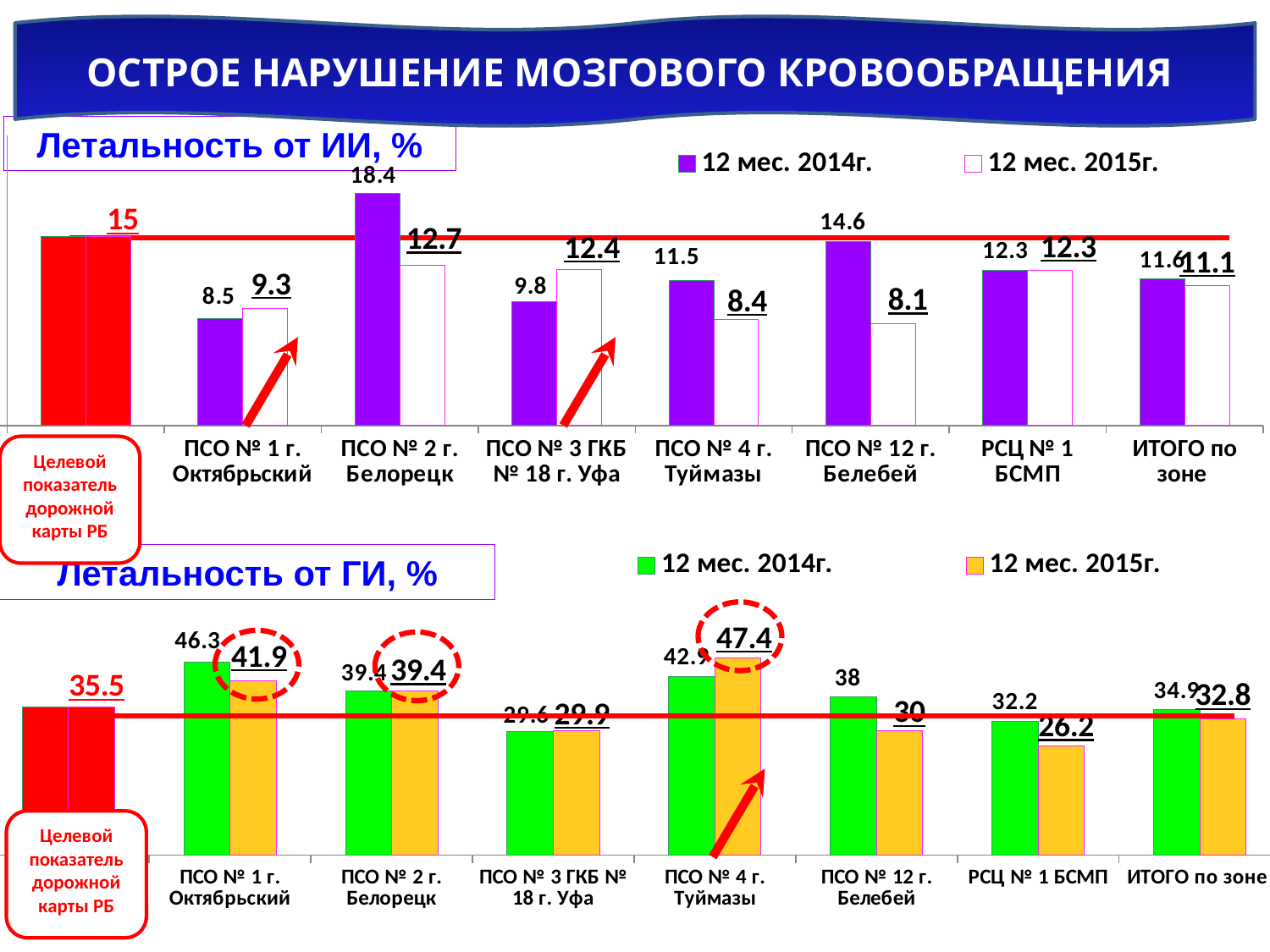
In the chart 'Летальность от ИИ, %', which category has the lowest value for 12 мес. 2015г.? ПСО № 12 г. Белебей In the chart 'Летальность от ИИ, %', which category has the highest value for 12 мес. 2014г.? ПСО № 2 г. Белорецк In the chart 'Летальность от ГИ, %', which category has the highest value for 12 мес. 2015г.? ПСО № 4 г. Туймазы In the chart 'Летальность от ИИ, %', what is the value for ПСО № 12 г. Белебей in 12 мес. 2015г.? 8.1 In the chart 'Летальность от ИИ, %', what is the target value (Целевой показатель) shown by the red bar? 15 In the chart 'Летальность от ГИ, %', what is the value for ИТОГО по зоне in 12 мес. 2014г.? 34.9 In the chart 'Летальность от ИИ, %', what is the value for ПСО № 2 г. Белорецк in 12 мес. 2014г.? 18.4 In the chart 'Летальность от ИИ, %', what is the difference between the 12 мес. 2014г. and 12 мес. 2015г. values for ПСО № 2 г. Белорецк? 5.7 In the chart 'Летальность от ГИ, %', what is the value for ПСО № 4 г. Туймазы in 12 мес. 2015г.? 47.4 In the chart 'Летальность от ГИ, %', which is larger for ПСО № 1 г. Октябрьский: the 12 мес. 2014г. value or the 12 мес. 2015г. value? 12 мес. 2014г. How many series does the legend of the chart 'Летальность от ГИ, %' list? 2 What type of chart is 'Летальность от ИИ, %'? Bar chart